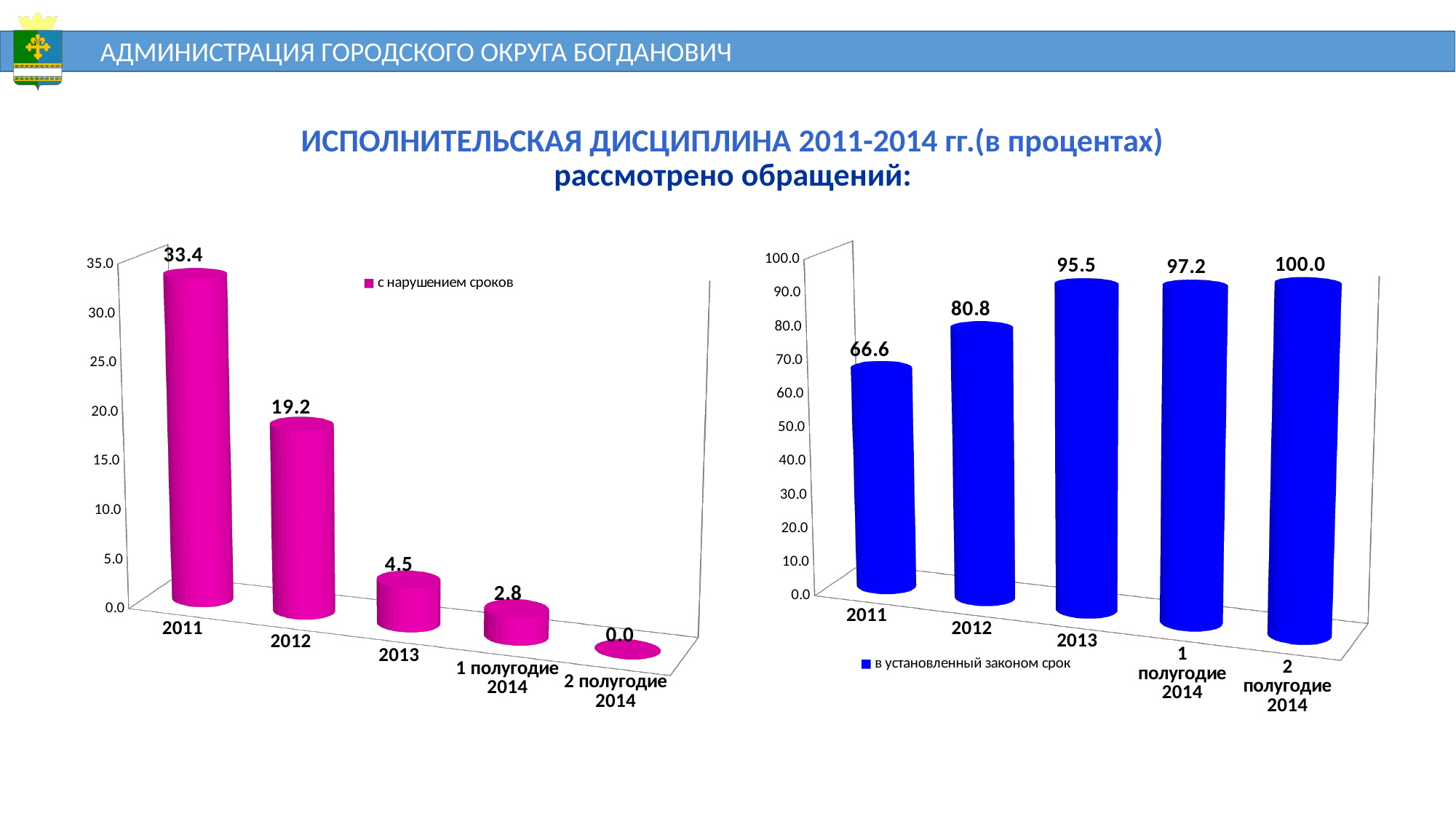
In the right chart (в установленный законом срок), what is the difference between the values for 2013 and 2011? 28.9 In the right chart (в установленный законом срок), what is the value for 2012? 80.8 How many categories are shown in the left chart (с нарушением сроков)? 5 In the left chart (с нарушением сроков), what is the difference between the values for 2011 and 2012? 14.2 In the right chart (в установленный законом срок), which is larger: the value for 2012 or the value for 2013? 2013 In the left chart (с нарушением сроков), what is the value for 2011? 33.4 In the right chart (в установленный законом срок), do the values rise or fall from 2011 to 2 полугодие 2014? rise In the left chart (с нарушением сроков), what is the value for 1 полугодие 2014? 2.8 In the left chart (с нарушением сроков), which category has the lowest value? 2 полугодие 2014 What type of chart is the right chart (в установленный законом срок)? bar chart In the right chart (в установленный законом срок), which category has the highest value? 2 полугодие 2014 What is the legend entry of the left chart? с нарушением сроков